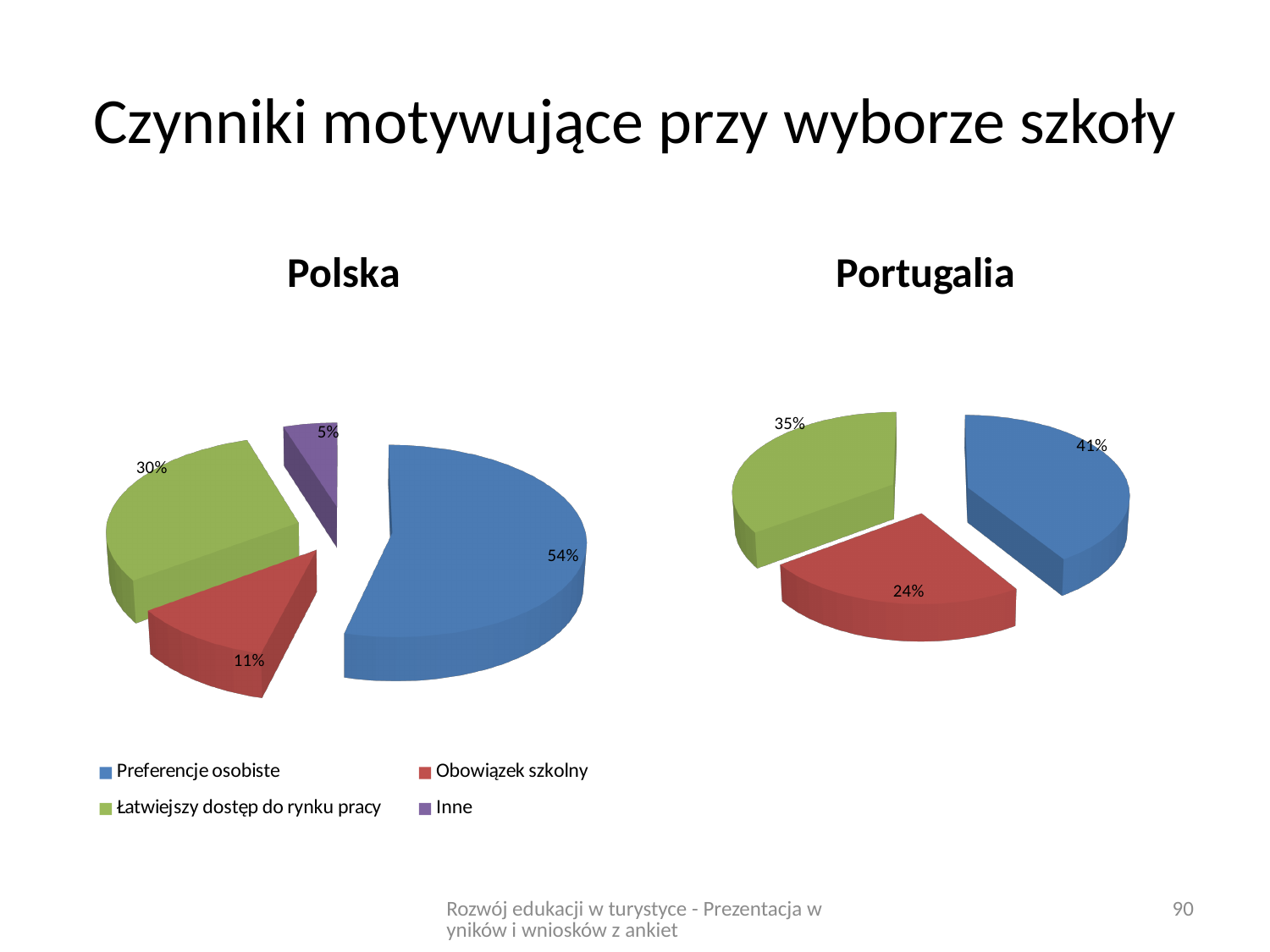
What is the difference between the Preferencje osobiste share in the Polska chart and in the Portugalia chart? 13 percentage points In the Portugalia chart, which category has the largest slice? Preferencje osobiste In the Polska chart, which category has the largest slice? Preferencje osobiste In the Portugalia chart, what share does Łatwiejszy dostęp do rynku pracy have? 35% Which is larger: Obowiązek szkolny in the Polska chart or Obowiązek szkolny in the Portugalia chart? Portugalia In the Polska chart, what share does Łatwiejszy dostęp do rynku pracy have? 30% In the Portugalia chart, what share does Obowiązek szkolny have? 24% How many slices does the Portugalia pie chart have? 3 In the Polska chart, which category has the smallest slice? Inne In the Polska chart, what share does Preferencje osobiste have? 54% How many entries does the legend list? 4 What type of chart is used for Polska and Portugalia? Pie chart